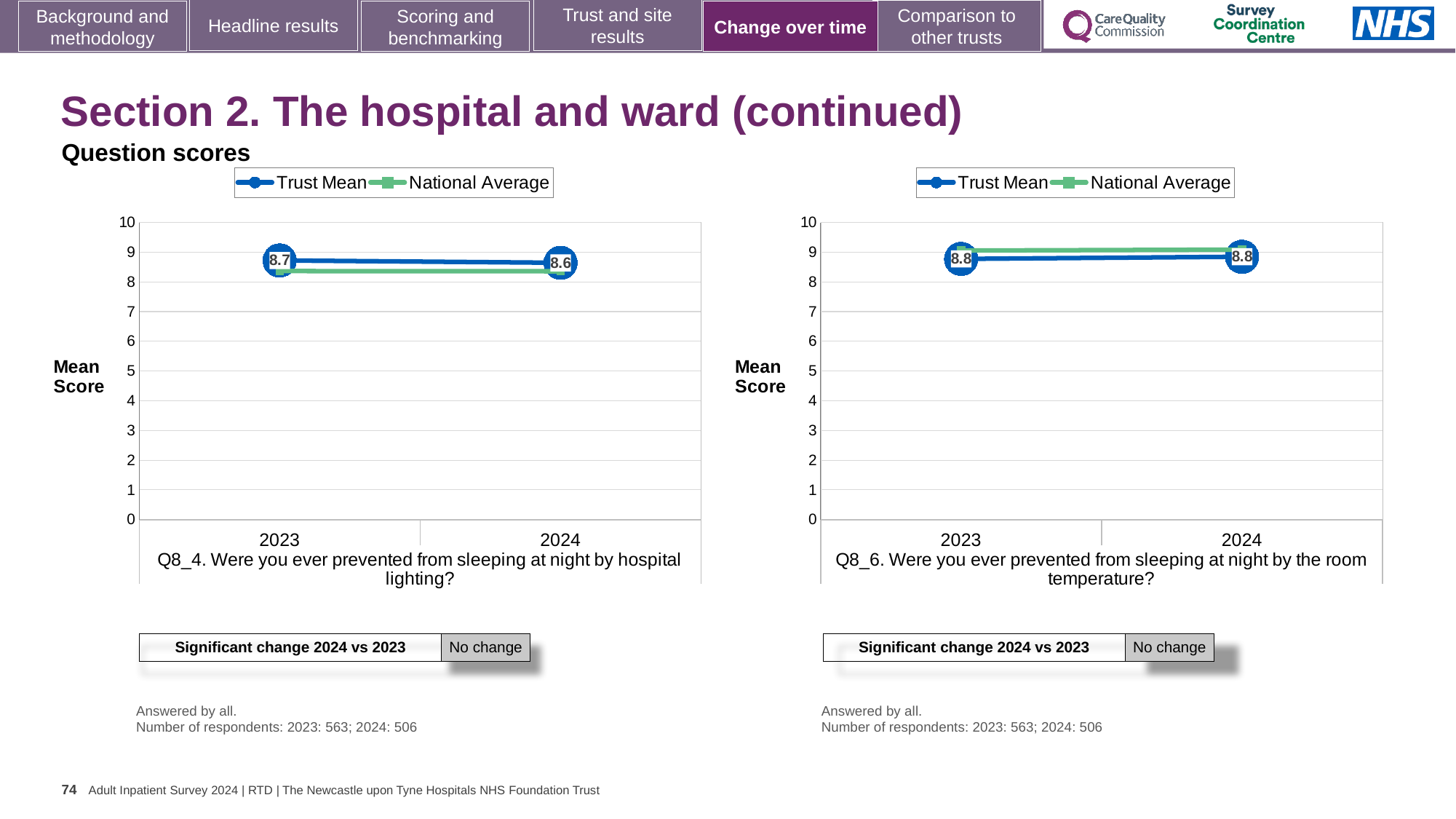
In the Q8_4 hospital lighting chart, does the Trust Mean rise or fall from 2023 to 2024? fall In the Q8_4 hospital lighting chart, is the National Average for 2024 greater or less than 9? less In the Q8_4 hospital lighting chart, which is higher in 2023, the Trust Mean or the National Average? Trust Mean In the Q8_4 hospital lighting chart, what is the difference between the Trust Mean for 2023 and 2024? 0.1 In the Q8_4 hospital lighting chart, what is the Trust Mean for 2023? 8.7 In the Q8_6 room temperature chart, what is the Trust Mean for 2024? 8.8 In the Q8_6 room temperature chart, which is higher in 2023, the Trust Mean or the National Average? National Average What kind of chart is the Q8_6 room temperature chart? line chart In the Q8_4 hospital lighting chart, what is the Trust Mean for 2024? 8.6 How many series does the legend of the Q8_4 hospital lighting chart list? 2 In the Q8_6 room temperature chart, does the Trust Mean rise, fall or stay the same from 2023 to 2024? stay the same In the Q8_6 room temperature chart, is the National Average for 2023 greater or less than 8? greater